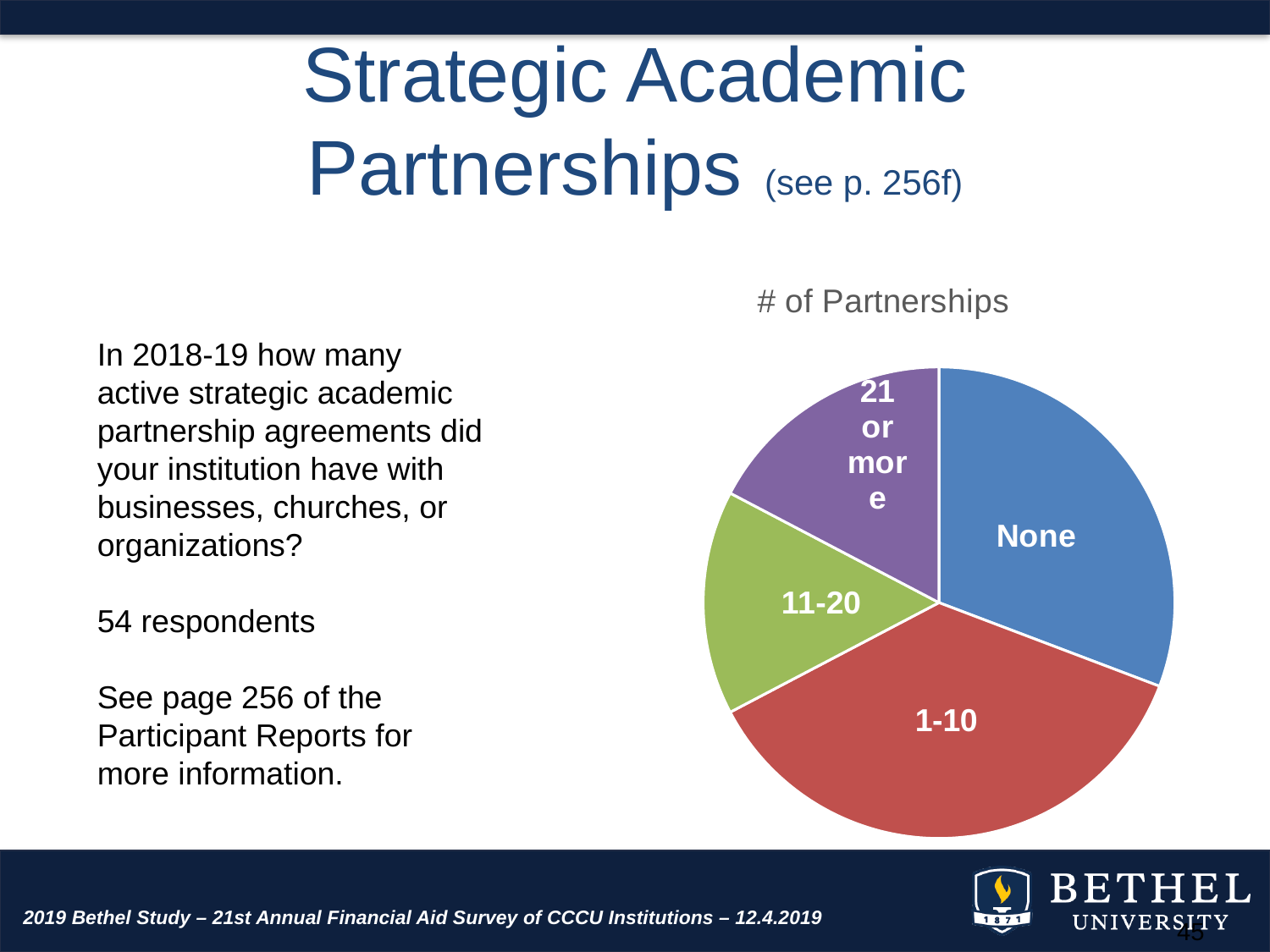
What colour is the "None" slice of the pie chart? blue How many slices does the pie chart have? 4 Which slice is larger, "1-10" or "11-20"? 1-10 Which slice is larger, "None" or "11-20"? None What is the title of the pie chart? # of Partnerships What kind of chart is shown on the slide? pie chart Which slice is larger, "None" or "21 or more"? None